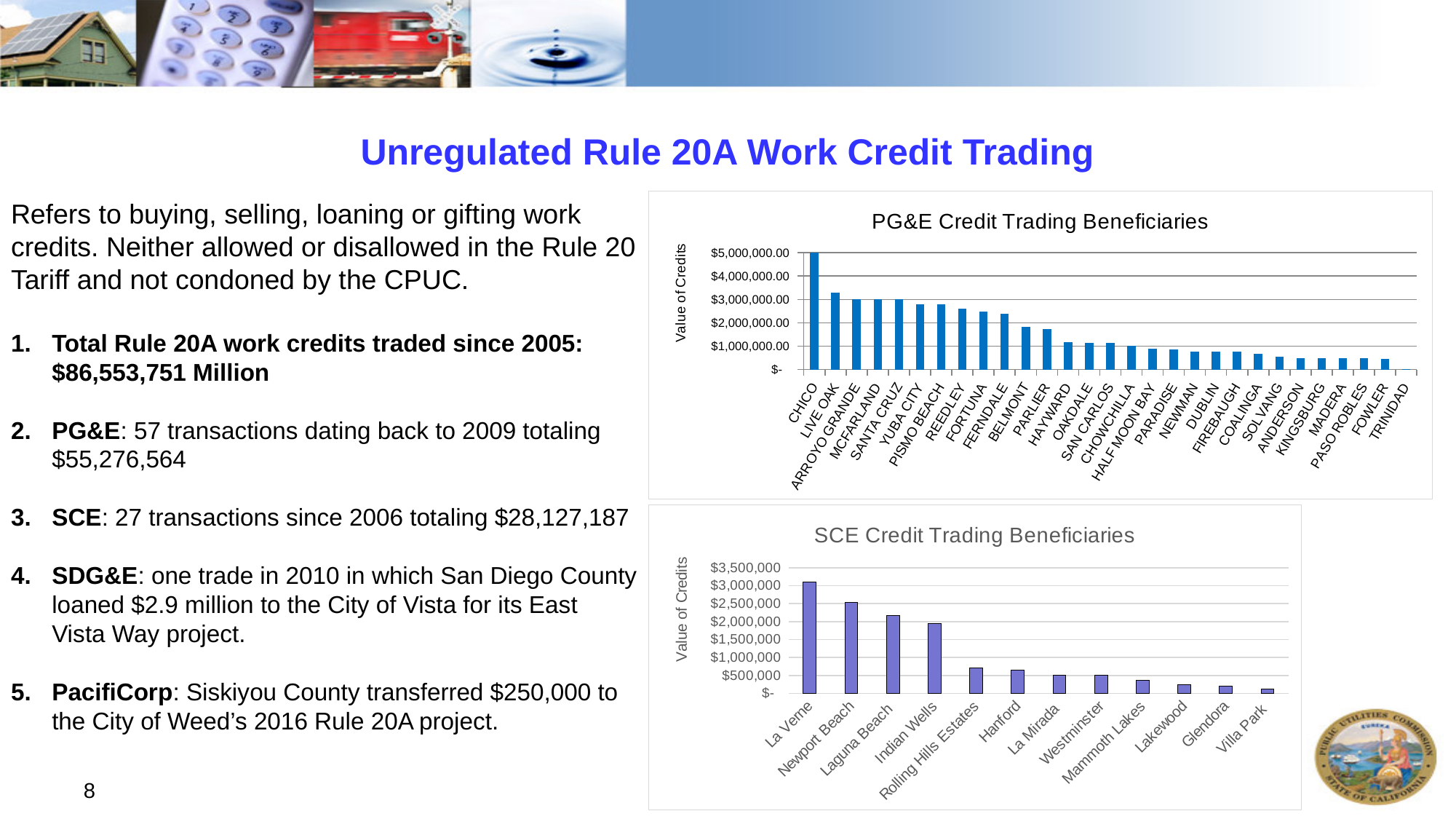
How many beneficiaries are shown in the SCE Credit Trading Beneficiaries chart? 12 In the SCE Credit Trading Beneficiaries chart, which beneficiary has the lowest value of credits? Villa Park What kind of chart is the PG&E Credit Trading Beneficiaries chart? Bar chart In the SCE Credit Trading Beneficiaries chart, which beneficiary has the highest value of credits? La Verne In the PG&E Credit Trading Beneficiaries chart, is the value for BELMONT greater or less than $2,000,000.00? less In the SCE Credit Trading Beneficiaries chart, which has a larger value of credits, Newport Beach or Indian Wells? Newport Beach In the SCE Credit Trading Beneficiaries chart, is the value for La Verne greater or less than $3,000,000? greater In the PG&E Credit Trading Beneficiaries chart, do the values rise or fall from left to right along the x axis? Fall In the PG&E Credit Trading Beneficiaries chart, which has a larger value of credits, CHICO or LIVE OAK? CHICO In the PG&E Credit Trading Beneficiaries chart, is the value for CHICO greater or less than $4,000,000.00? greater In the PG&E Credit Trading Beneficiaries chart, which beneficiary has the highest value of credits? CHICO